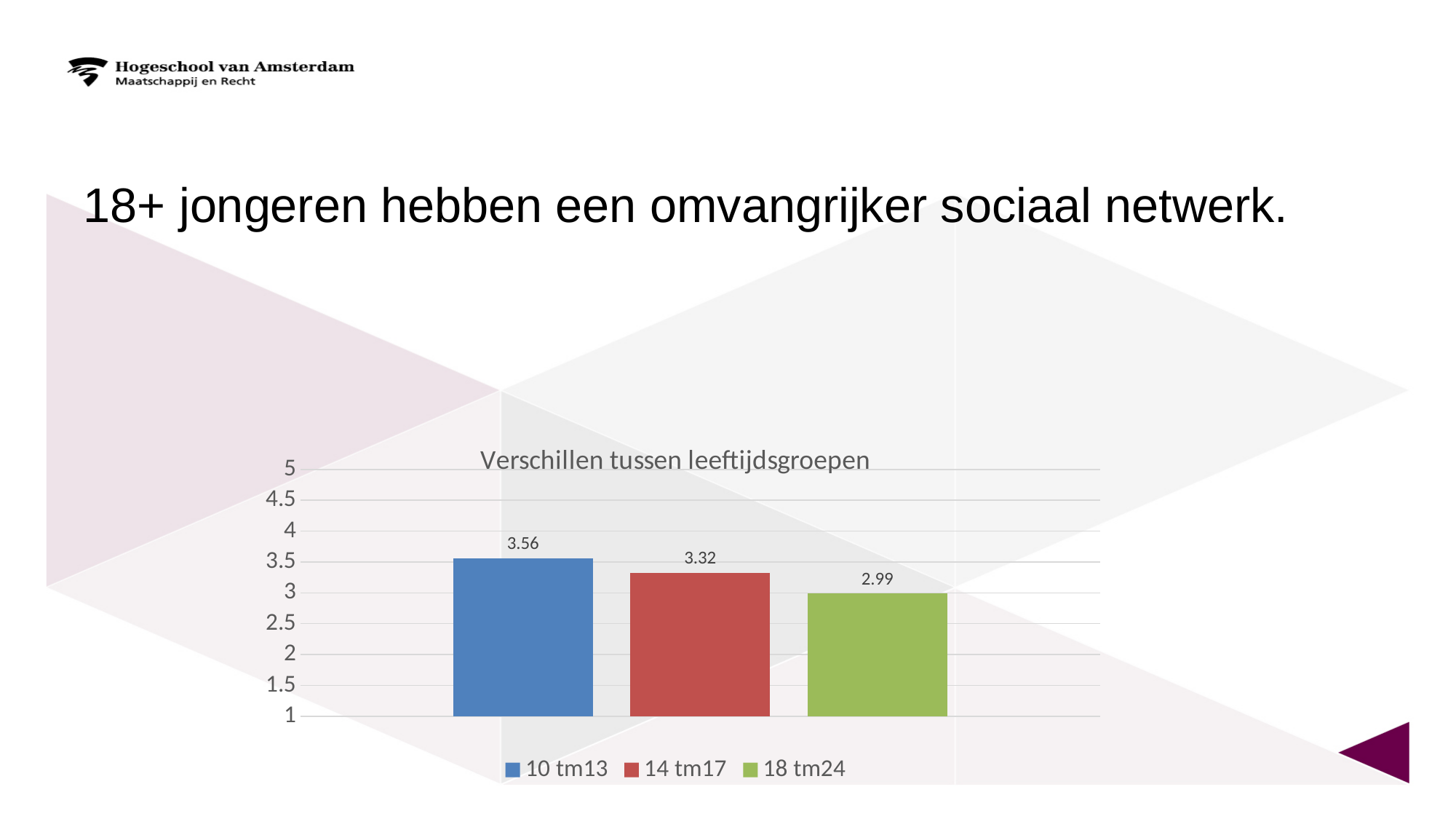
What is the value for 14 tm17? 3.32 How many series does the legend list? 3 What kind of chart is shown? bar chart What is the difference between the values for 10 tm13 and 14 tm17? 0.24 What is the value for 10 tm13? 3.56 What is the difference between the values for 10 tm13 and 18 tm24? 0.57 What is the value for 18 tm24? 2.99 Which group has the lowest value? 18 tm24 Which group has the highest value? 10 tm13 Is the value for 18 tm24 greater or less than 3? less What is the title of the chart? Verschillen tussen leeftijdsgroepen Which is larger, the value for 14 tm17 or the value for 18 tm24? 14 tm17